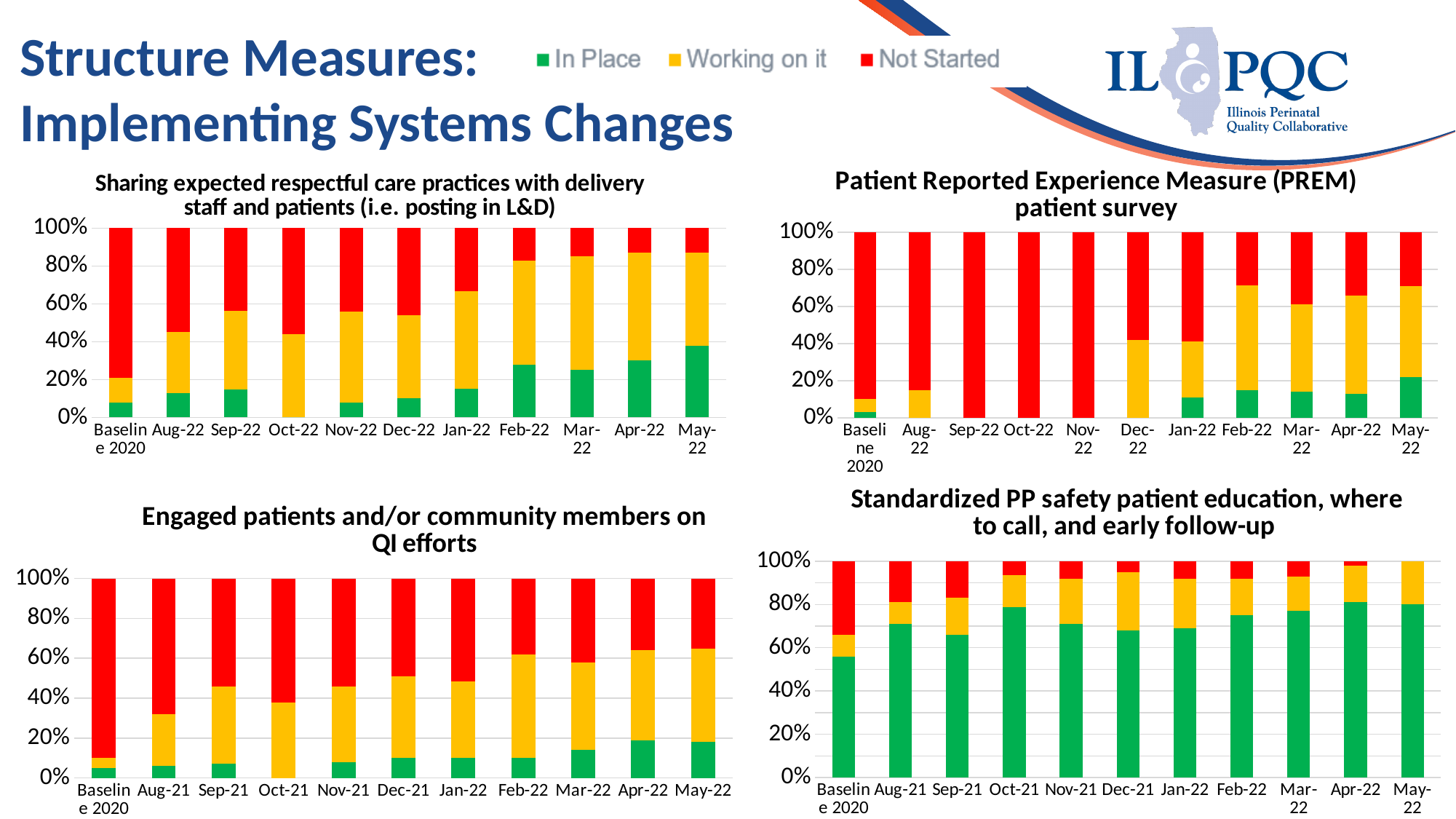
In the 'Standardized PP safety patient education' chart, is the 'In Place' share for Oct-21 greater or less than 60%? greater In the 'Patient Reported Experience Measure (PREM) patient survey' chart, which period has the largest 'In Place' share? May-22 How many time periods are shown on the x axis of the 'Engaged patients and/or community members on QI efforts' chart? 11 In the 'Patient Reported Experience Measure (PREM) patient survey' chart, which periods are entirely 'Not Started'? Sep-22, Oct-22, Nov-22 What kind of chart is the 'Patient Reported Experience Measure (PREM) patient survey' chart? Stacked bar chart In the 'Standardized PP safety patient education' chart, which period has the smallest 'In Place' share? Baseline 2020 In the 'Sharing expected respectful care practices' chart, which period has the largest 'In Place' share? May-22 In the 'Engaged patients and/or community members on QI efforts' chart, is the 'Not Started' share for Baseline 2020 greater or less than 80%? greater In the 'Sharing expected respectful care practices' chart, is the 'In Place' share for May-22 greater or less than 20%? greater How many series does the legend at the top of the slide list? 3 In the 'Sharing expected respectful care practices' chart, does the 'In Place' share generally rise or fall from Baseline 2020 to May-22? rise Which colour represents 'Working on it' in the legend? Yellow